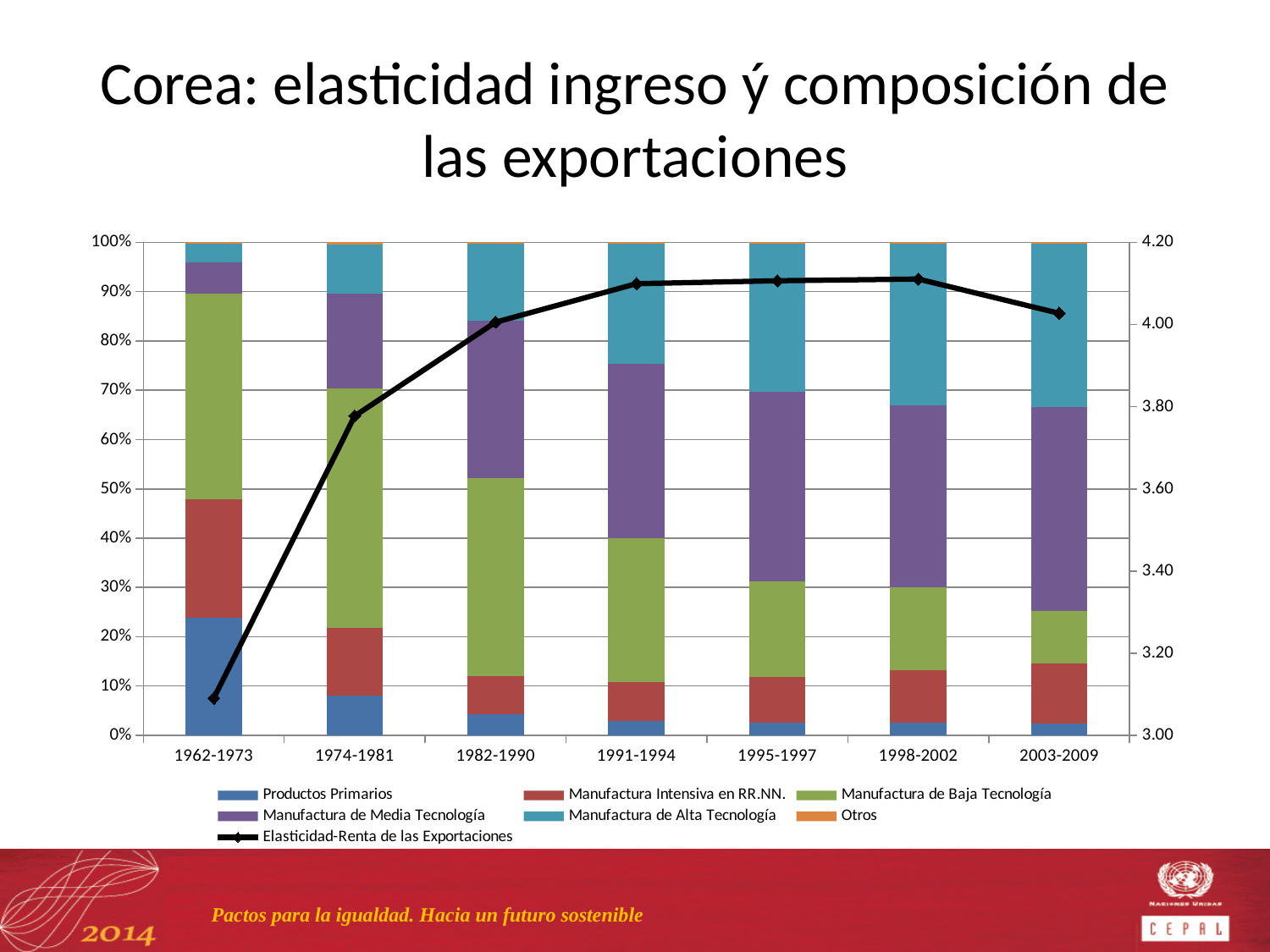
What kind of chart is shown on the slide? Stacked bar chart with a line Does the Elasticidad-Renta de las Exportaciones line rise or fall from 1962-1973 to 1995-1997? rise How many time periods are shown on the x axis? 7 Is the Elasticidad-Renta de las Exportaciones value for 1962-1973 greater or less than 3.20? less Is the Elasticidad-Renta de las Exportaciones value for 1974-1981 greater or less than 3.60? greater How many series does the legend list? 7 Which series is plotted as a line on the right-hand axis? Elasticidad-Renta de las Exportaciones Is the share of Productos Primarios in 1962-1973 greater or less than 20%? greater In which period is the Elasticidad-Renta de las Exportaciones line at its lowest? 1962-1973 Which period has the larger share of Manufactura de Alta Tecnología, 1962-1973 or 2003-2009? 2003-2009 In which period is the share of Productos Primarios the largest? 1962-1973